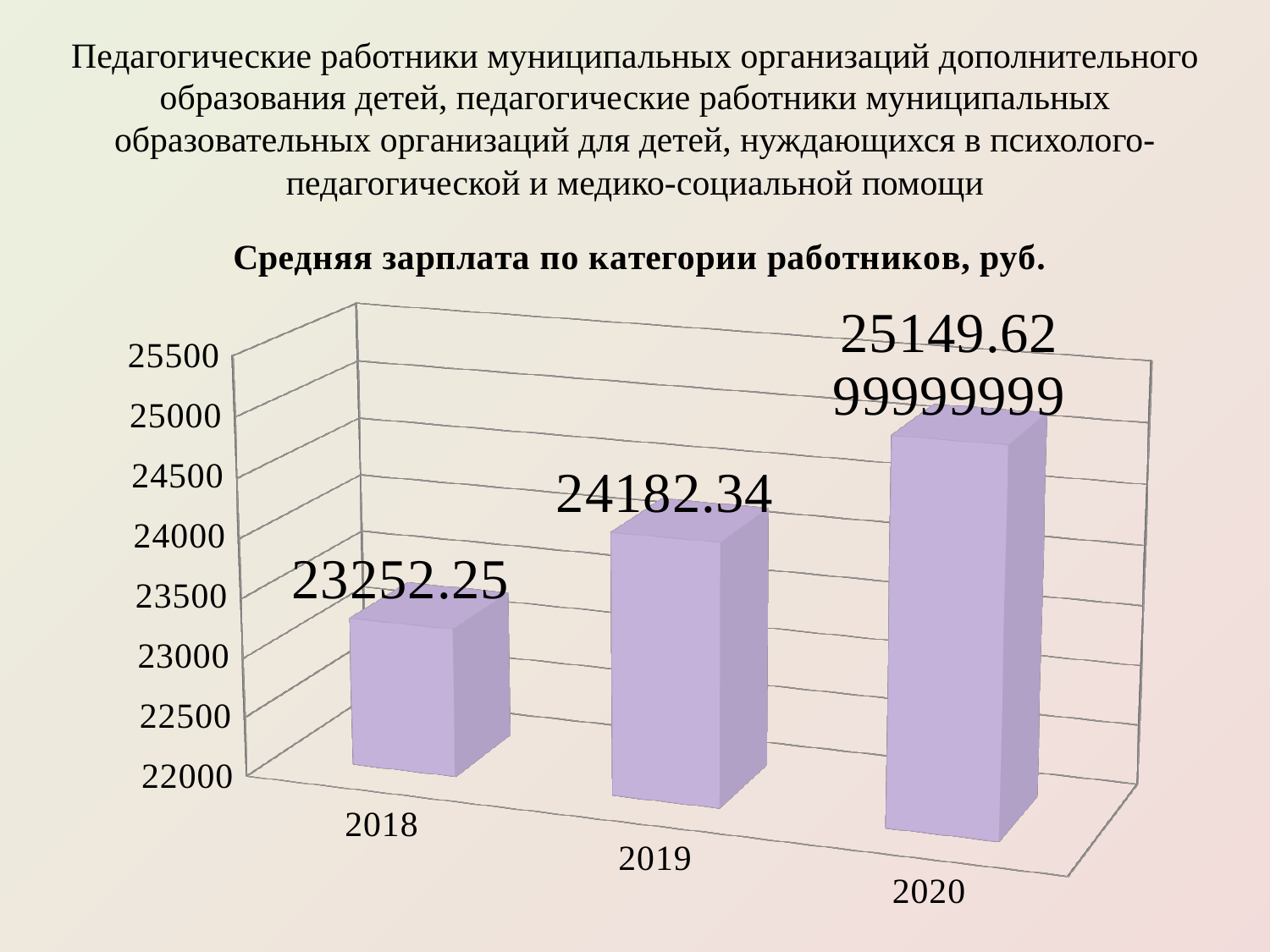
What is the title of the chart? Средняя зарплата по категории работников, руб. Is the value for 2020 greater or less than 25000? greater What type of chart is shown on the slide? bar chart Is the value for 2018 greater or less than 23500? less Which year has the highest average salary in the chart? 2020 What is the average salary value shown for 2018? 23252.25 Which year has the larger value, 2018 or 2019? 2019 Which year has the lowest average salary in the chart? 2018 How many years (bars) are shown in the chart? 3 By how much does the 2019 value exceed the 2018 value? 930.09 Do the values rise or fall from 2018 to 2020? rise What is the average salary value shown for 2019? 24182.34